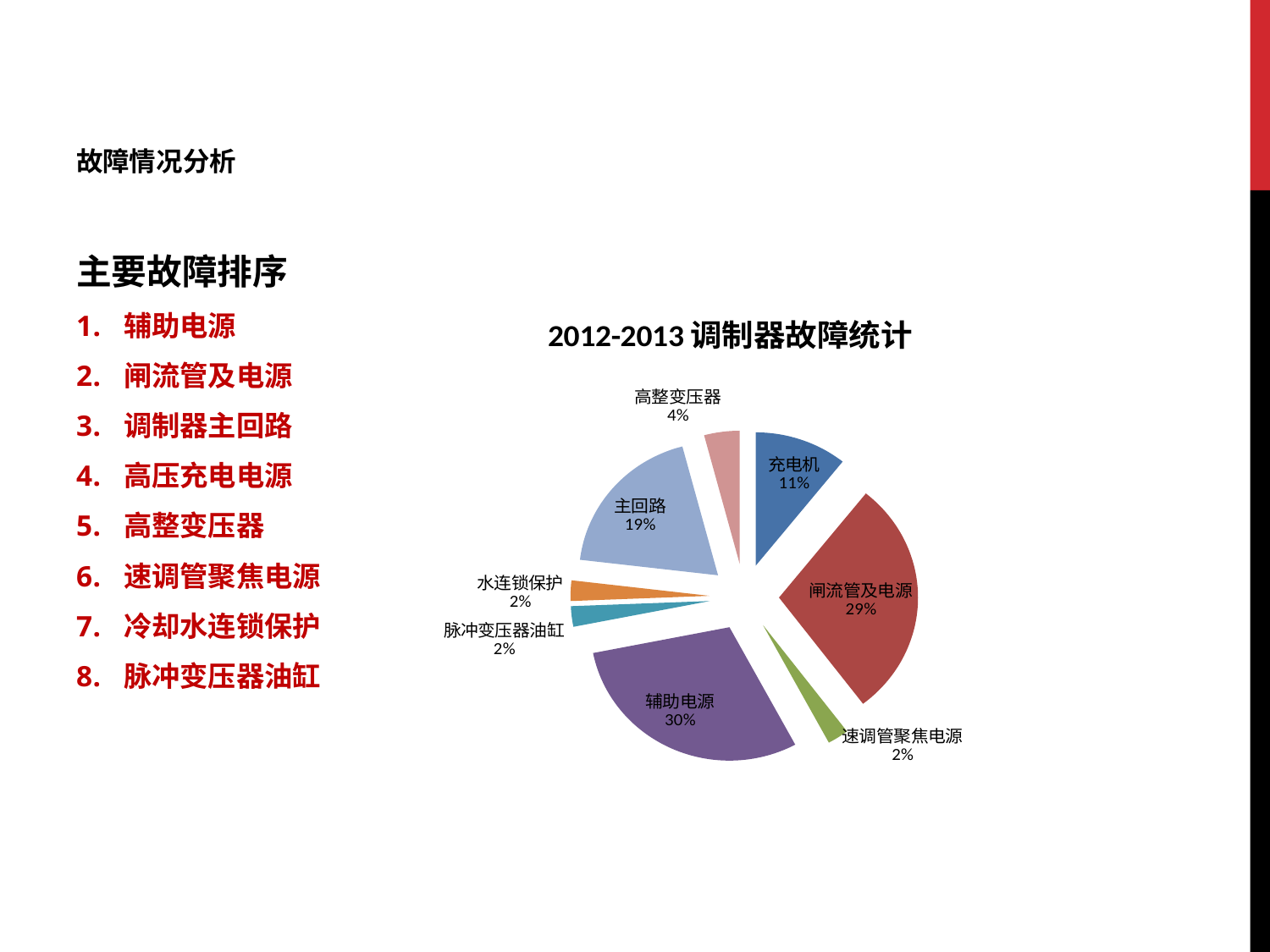
What percentage is shown for 高整变压器? 4% How many slices does the pie chart have? 8 What is the title of the chart? 2012-2013 调制器故障统计 What percentage is shown for 主回路? 19% What percentage is shown for 闸流管及电源? 29% What share of the pie does 辅助电源 represent? 30% Which is larger, the share for 主回路 or the share for 充电机? 主回路 What kind of chart is shown on the slide? pie chart What is the difference in percentage points between 闸流管及电源 and 主回路? 10 What percentage is shown for 速调管聚焦电源? 2% What percentage is shown for 充电机? 11% Which category has the largest slice of the pie? 辅助电源